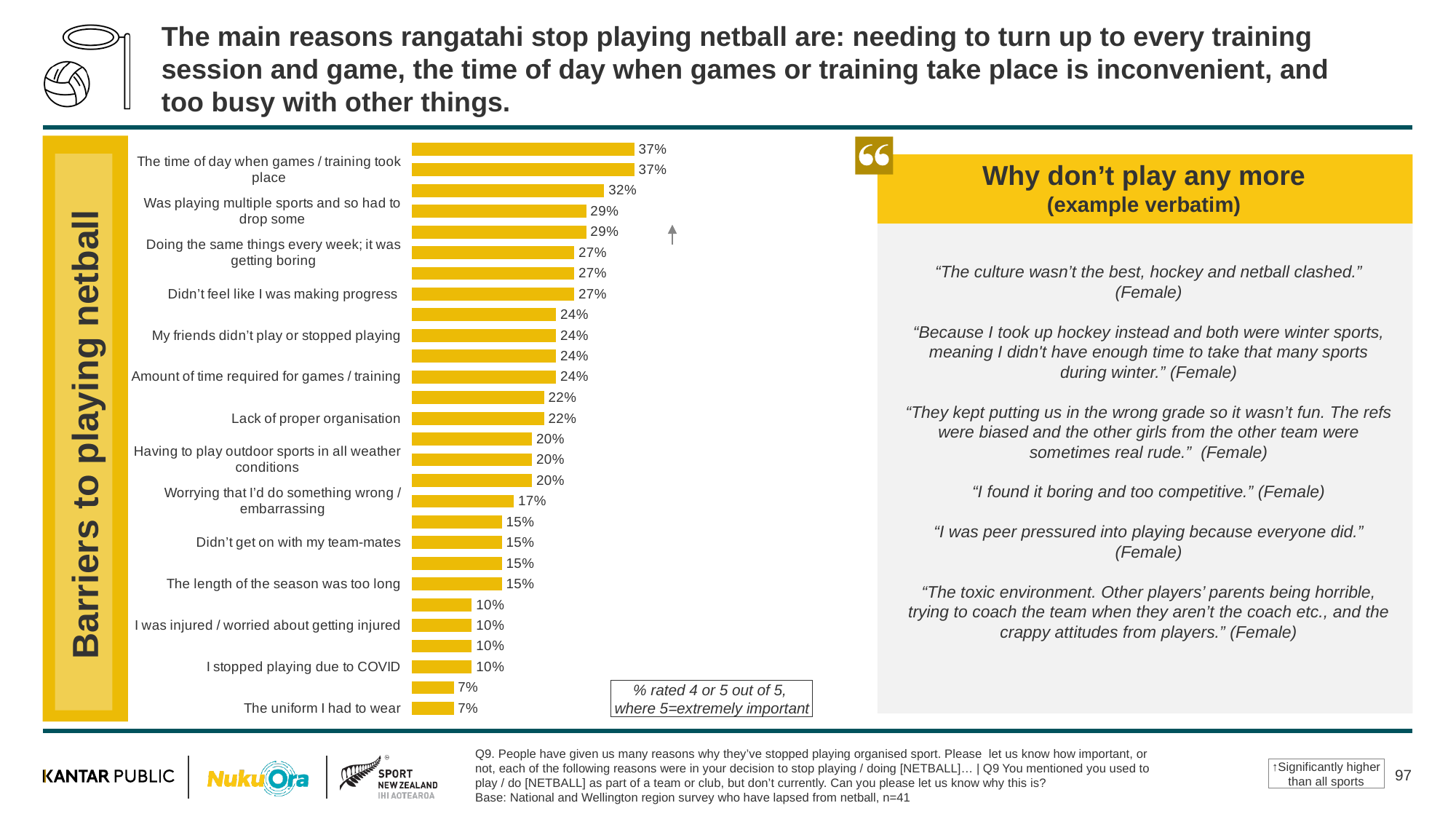
What percentage is shown for 'The uniform I had to wear'? 7% What is the highest value shown on the barriers to playing netball chart? 37% What is the difference in percentage points between 'The time of day when games / training took place' and 'The uniform I had to wear'? 30 percentage points What type of chart is used to show the barriers to playing netball? Bar chart What percentage is shown for 'The time of day when games / training took place'? 37% What is the lowest value shown on the barriers to playing netball chart? 7% What percentage is shown for 'Lack of proper organisation'? 22% Which has a higher value: 'Lack of proper organisation' or 'The uniform I had to wear'? Lack of proper organisation According to the note on the chart, what do the percentages represent? % rated 4 or 5 out of 5, where 5=extremely important What percentage is shown for 'Worrying that I'd do something wrong / embarrassing'? 17% How many bars are plotted on the barriers to playing netball chart? 28 What percentage is shown for 'I stopped playing due to COVID'? 10%